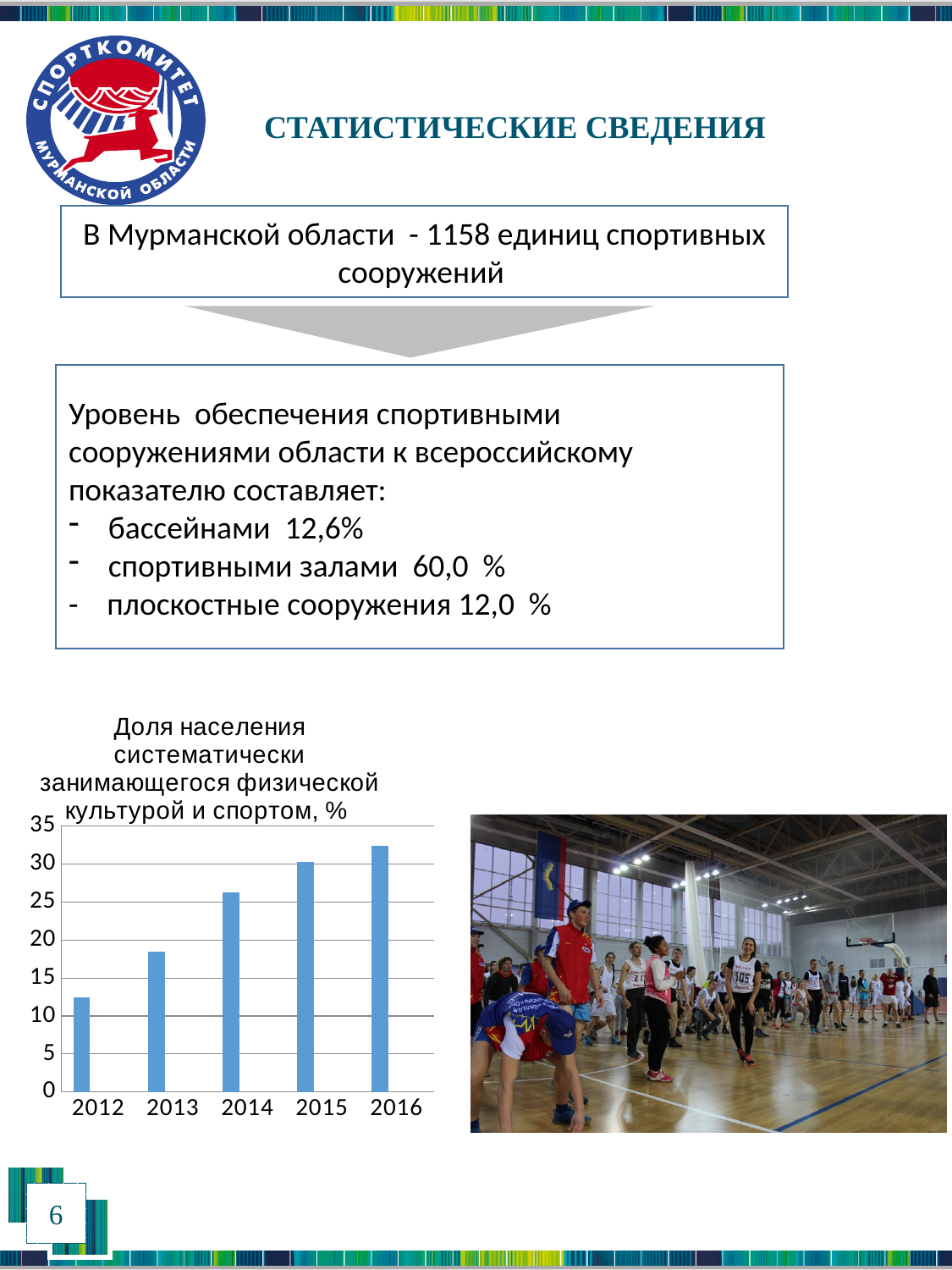
Is the value for 2012 greater or less than 15? less Is the value for 2013 greater or less than 15? greater Is the value for 2016 greater or less than 30? greater How many years are shown on the x axis of the chart? 5 What is the title of the chart on the slide? Доля населения систематически занимающегося физической культурой и спортом, % What kind of chart is shown on the slide? bar chart Which is larger, the value for 2014 or the value for 2013? 2014 Which year has the lowest value in the chart? 2012 Which year has the highest value in the chart? 2016 Do the values in the chart rise or fall from 2012 to 2016? rise